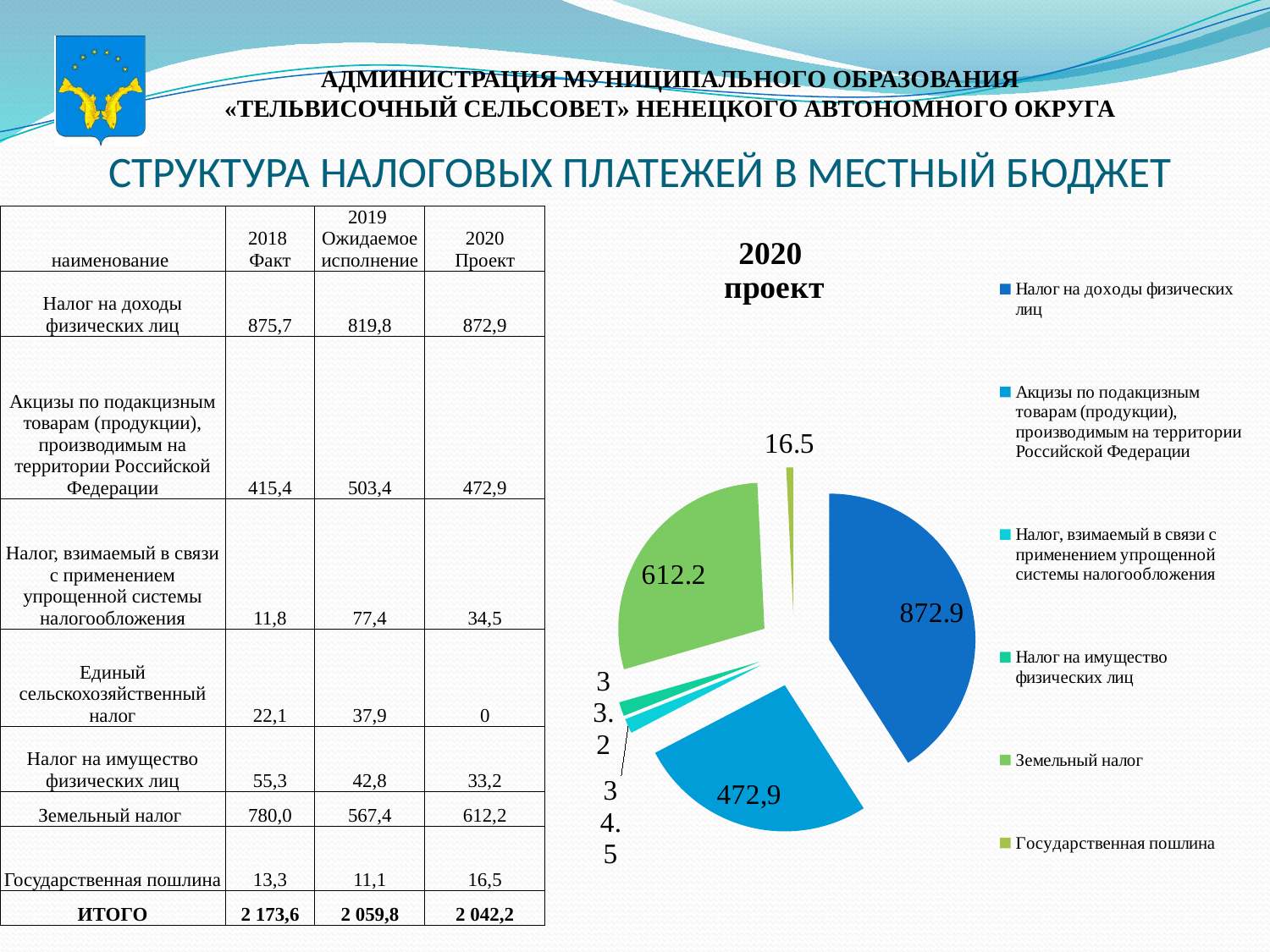
What value is shown for Государственная пошлина in the pie chart? 16.5 What value is shown for Акцизы по подакцизным товарам in the pie chart? 472,9 What kind of chart is shown on the slide? pie chart In the pie chart, which is larger: Земельный налог or Акцизы по подакцизным товарам? Земельный налог How many entries does the legend of the pie chart list? 6 Which category has the largest slice in the pie chart? Налог на доходы физических лиц What is the difference between the values for Налог на доходы физических лиц and Земельный налог in the pie chart? 260.7 What is the title of the pie chart? 2020 проект What value is shown for Земельный налог in the pie chart? 612.2 What value is shown for Налог на доходы физических лиц in the pie chart? 872.9 How many slices does the pie chart have? 6 Which category has the smallest slice in the pie chart? Государственная пошлина